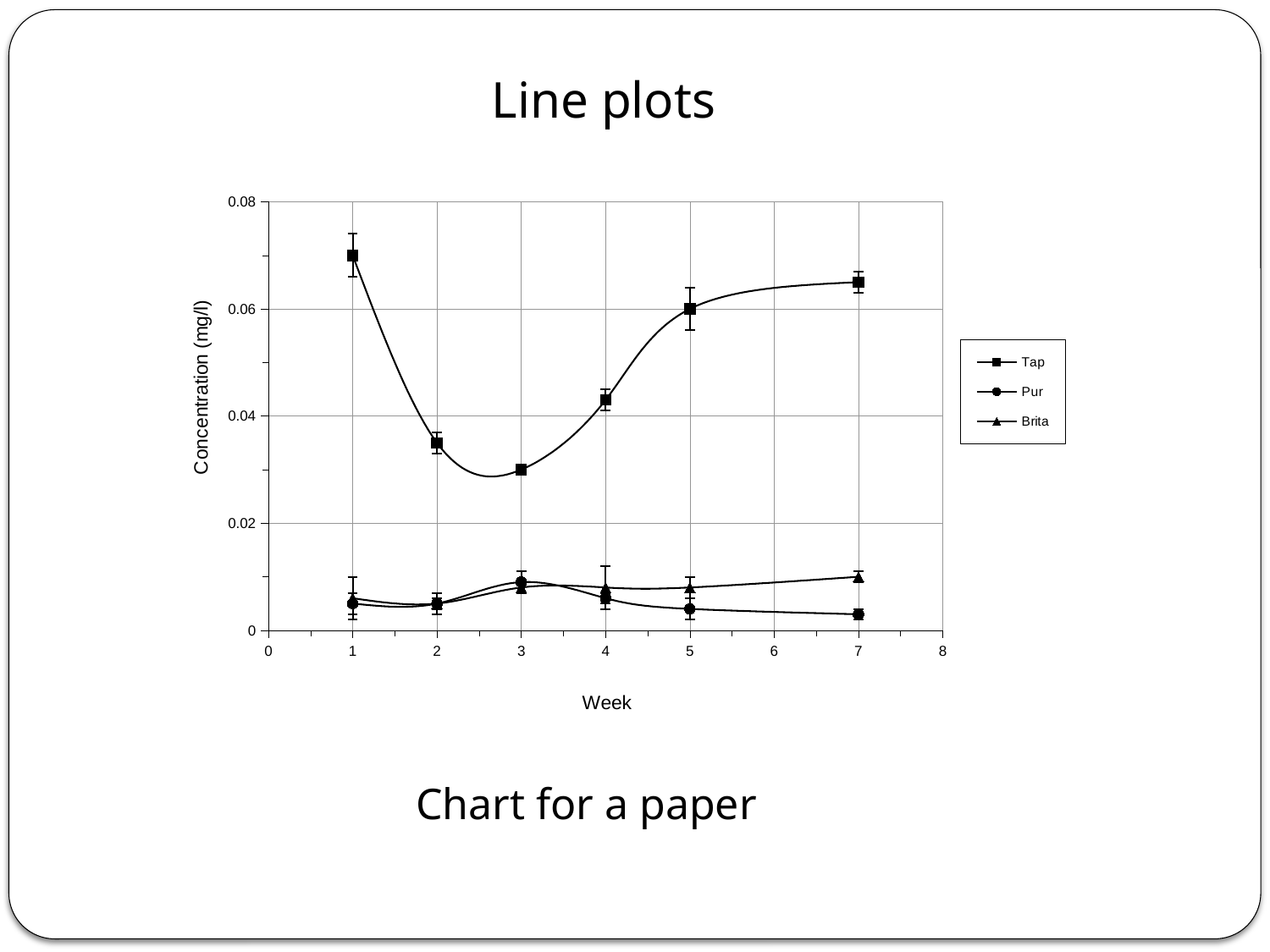
What are the names of the series in the legend? Tap, Pur, Brita What kind of chart is shown on the slide? Line chart How many data points are plotted for the Tap series? 6 Is the value for Tap at week 3 greater or less than 0.04? less Which series has the highest values across all weeks? Tap Does the Tap series rise or fall from week 1 to week 3? Fall Which series has the highest concentration at week 1, Tap or Pur? Tap Is the value for Tap at week 7 greater or less than 0.06? greater What is the label of the y axis? Concentration (mg/l) Is the value for Tap at week 1 greater or less than 0.06? greater How many series does the legend list? 3